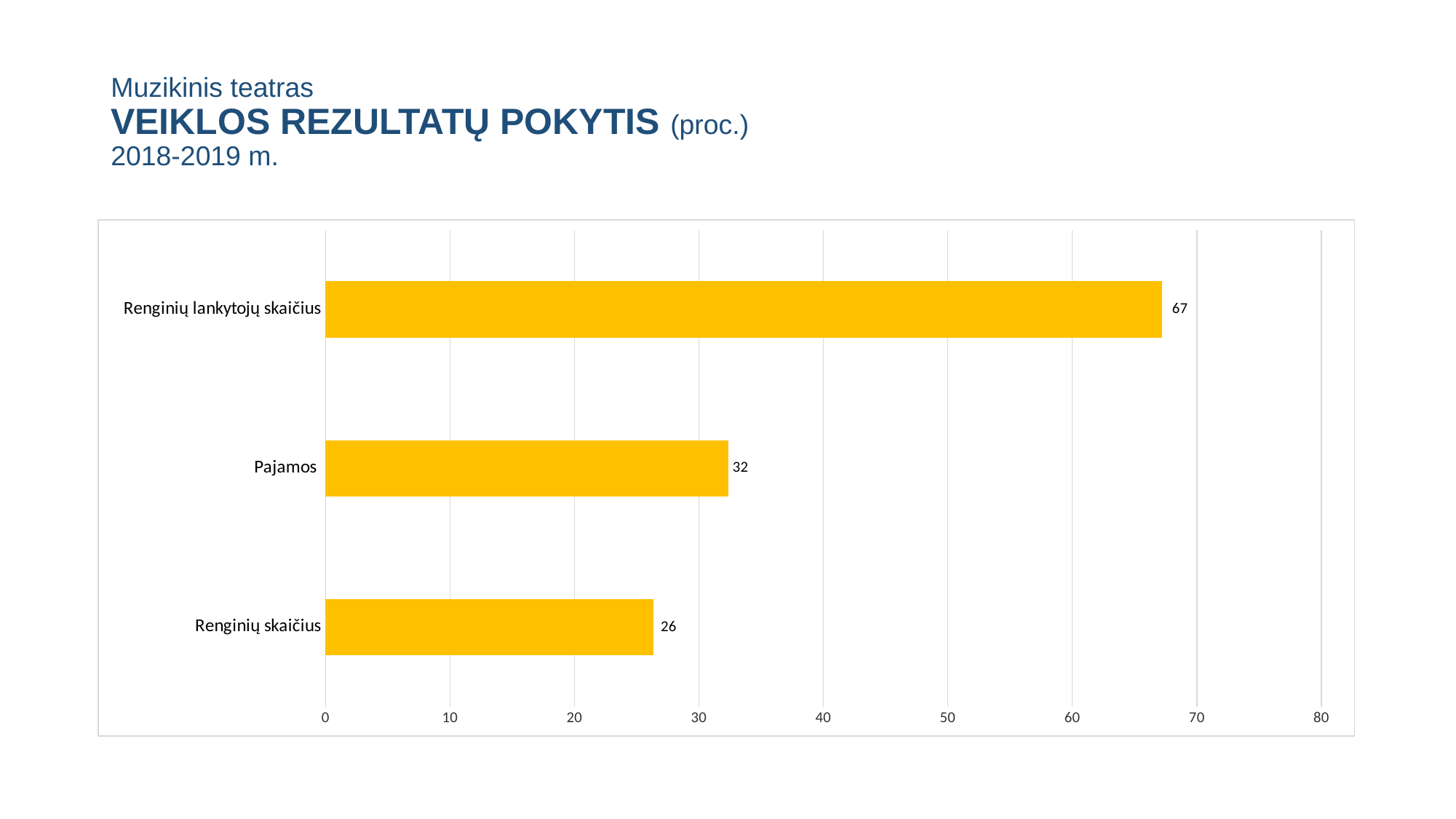
How many categories are shown in the chart? 3 Which category has the highest value? Renginių lankytojų skaičius What kind of chart is shown on the slide? bar chart What is the difference between the values for Renginių lankytojų skaičius and Pajamos? 35 Which category has the lowest value? Renginių skaičius Is the value for Renginių lankytojų skaičius greater or less than 60? greater What is the value for Renginių lankytojų skaičius? 67 What is the value for Pajamos? 32 What is the difference between the values for Pajamos and Renginių skaičius? 6 What is the highest value shown on the horizontal axis? 80 Which is larger, the value for Pajamos or the value for Renginių skaičius? Pajamos What is the value for Renginių skaičius? 26